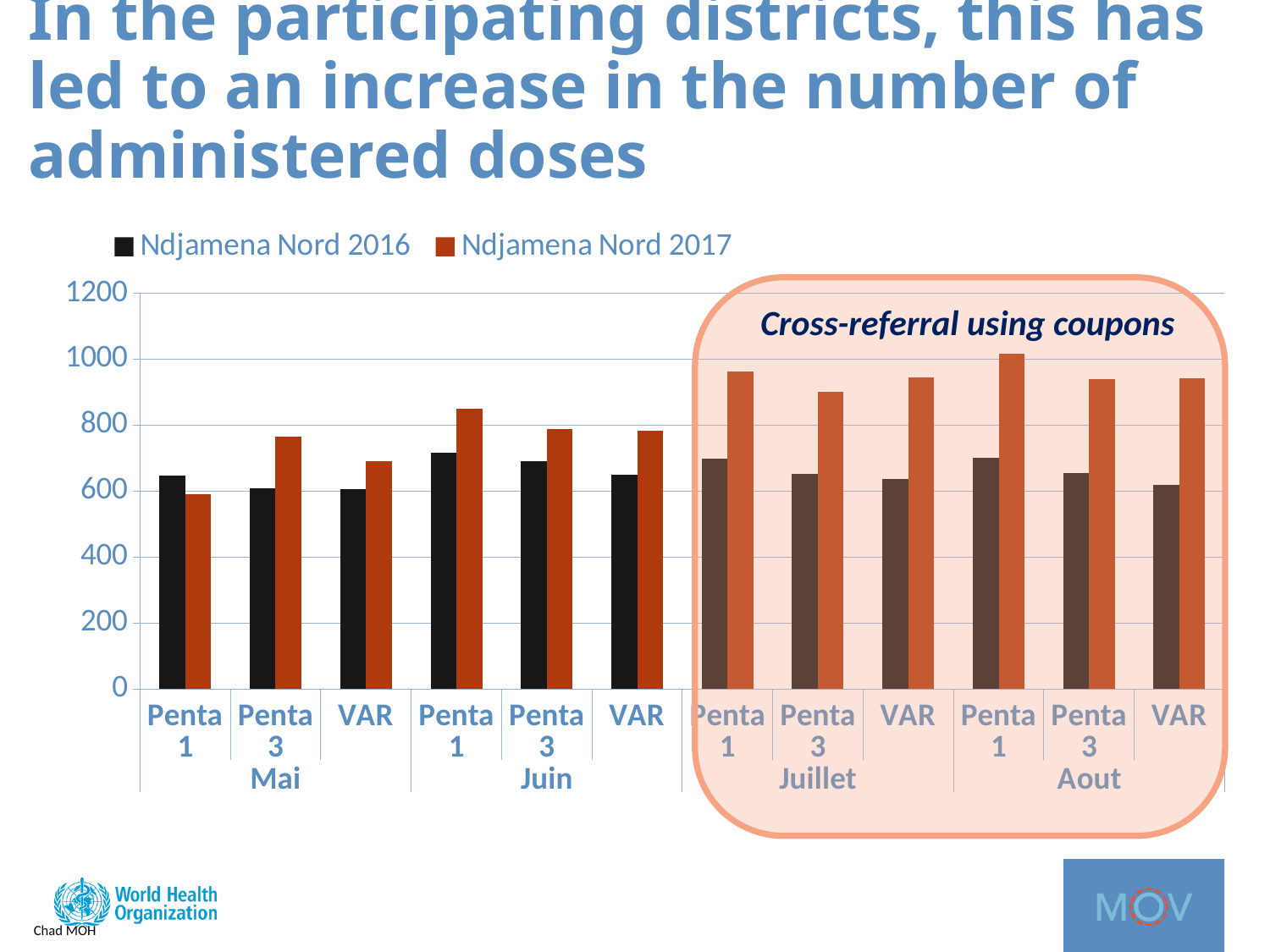
What kind of chart is shown on the slide? bar chart For Penta 1 in Mai, which series has the larger value, Ndjamena Nord 2016 or Ndjamena Nord 2017? Ndjamena Nord 2016 For VAR in Juillet, which series has the larger value, Ndjamena Nord 2016 or Ndjamena Nord 2017? Ndjamena Nord 2017 How many series does the legend list? 2 How many category groups (bar pairs) are plotted in total? 12 How many months are shown along the x axis? 4 What are the two series named in the legend? Ndjamena Nord 2016 and Ndjamena Nord 2017 Is the Ndjamena Nord 2017 value for Penta 1 in Aout greater or less than 1000? greater Which category has the lowest Ndjamena Nord 2017 value? Penta 1 in Mai Which category has the highest Ndjamena Nord 2017 value? Penta 1 in Aout What text appears in the highlighted box over the Juillet and Aout groups? Cross-referral using coupons